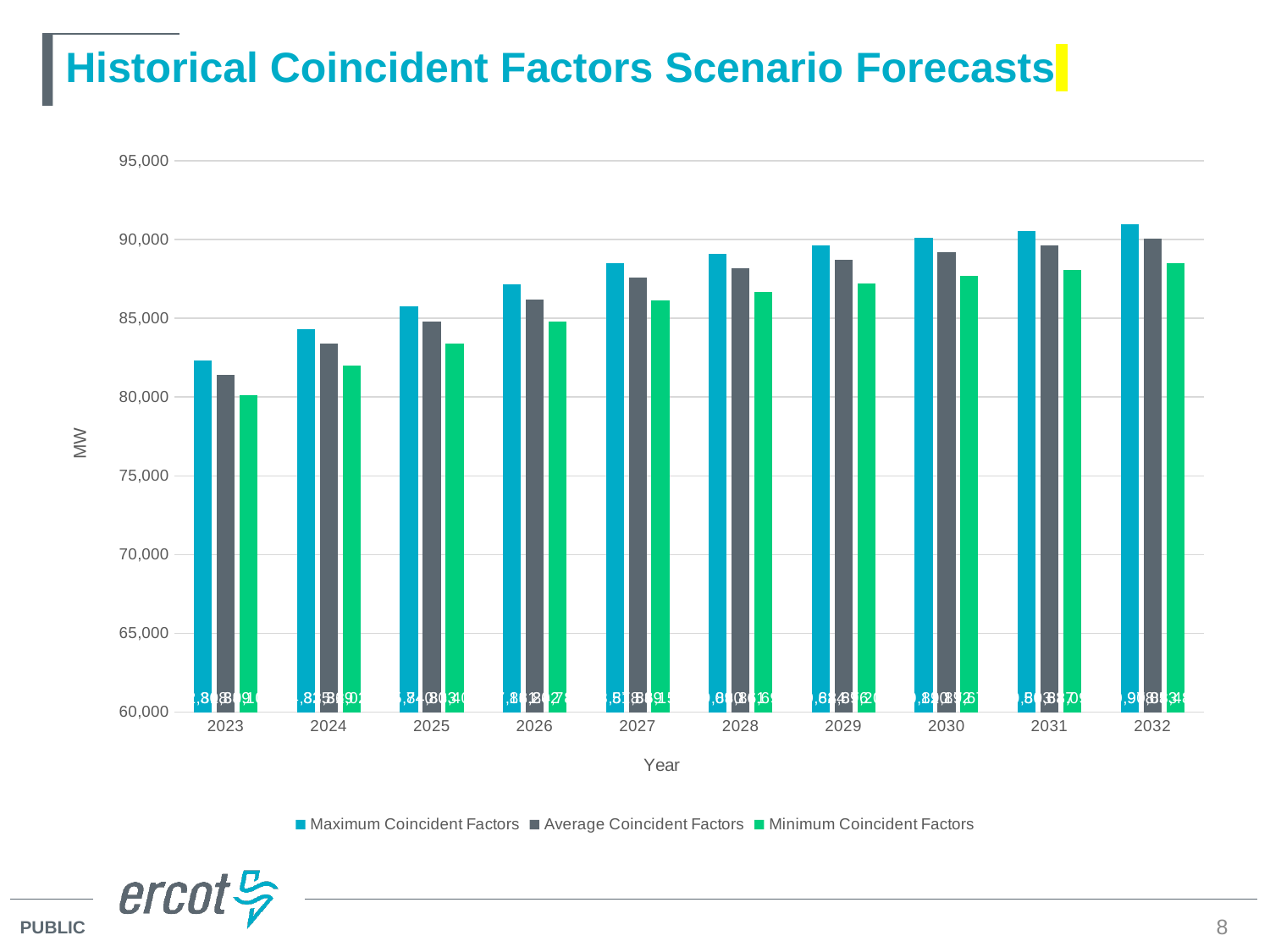
What is the label on the y axis? MW Which year has the highest Maximum Coincident Factors value? 2032 Is the Minimum Coincident Factors value for 2025 greater or less than 85,000? less What kind of chart is shown on the slide? Bar chart How many years are shown on the x axis? 10 In 2027, which is larger: the Maximum Coincident Factors value or the Minimum Coincident Factors value? Maximum Coincident Factors Which year has the lowest Minimum Coincident Factors value? 2023 Is the Minimum Coincident Factors value for 2032 greater or less than 90,000? less Is the Maximum Coincident Factors value for 2026 greater or less than 85,000? greater Do the Average Coincident Factors values rise or fall from 2023 to 2032? Rise How many series does the legend list? 3